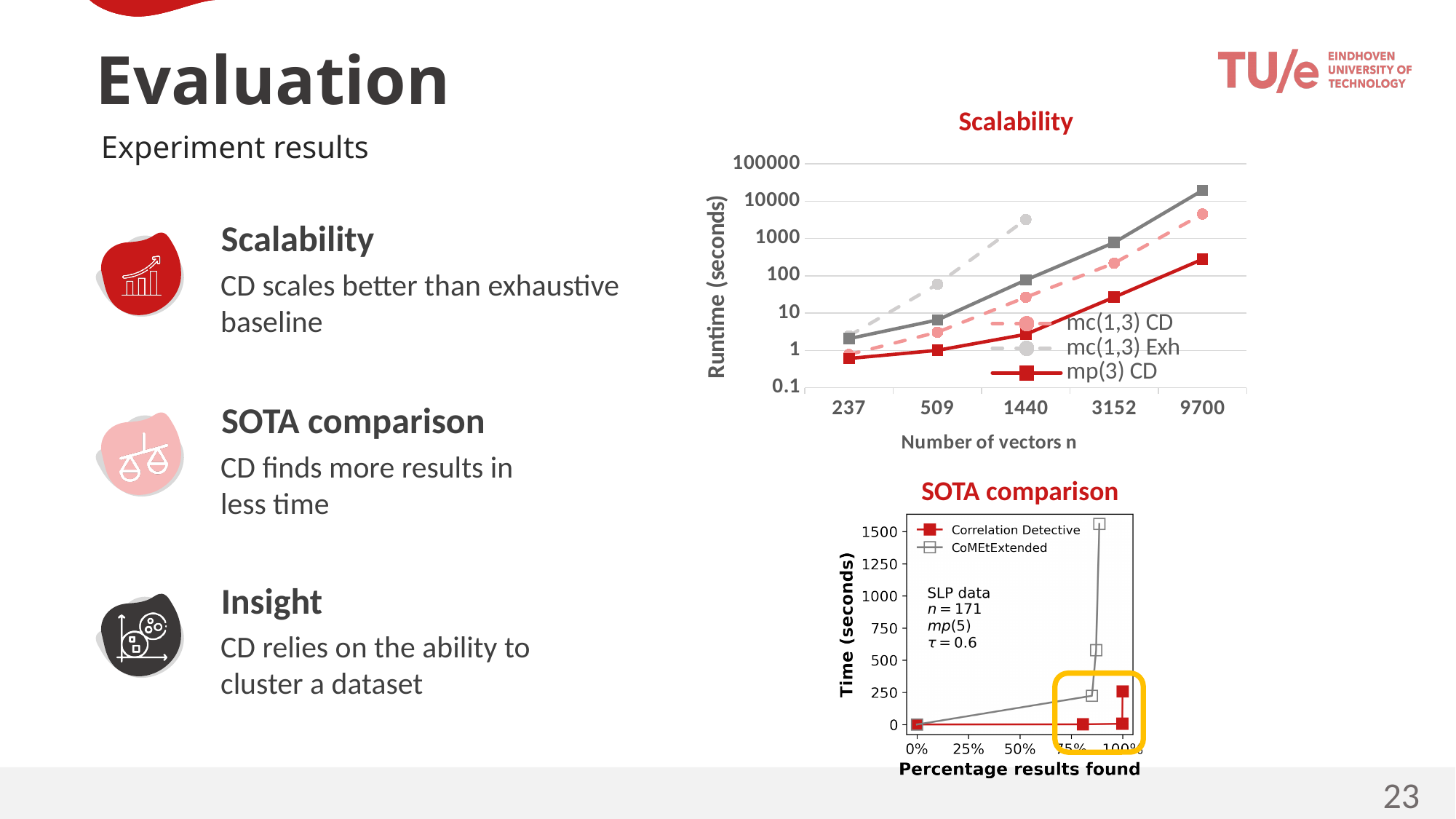
On the SOTA comparison chart, is the highest time for CoMEtExtended greater or less than 1250? greater On the Scalability chart, is the runtime for mc(1,3) Exh at n = 1440 greater or less than 1000? greater On the Scalability chart, how many values of n are shown on the x axis? 5 On the SOTA comparison chart, which series reaches the highest time? CoMEtExtended On the Scalability chart, is the runtime for mp(3) CD at n = 9700 greater or less than 100? greater On the SOTA comparison chart, what is the label of the x axis? Percentage results found On the SOTA comparison chart, how many series does the legend list? 2 On the Scalability chart, what is the label of the y axis? Runtime (seconds) On the Scalability chart, which series has the lowest runtime at n = 3152? mp(3) CD On the Scalability chart, does runtime rise or fall as the number of vectors n increases? rise On the Scalability chart, what kind of chart is it? line chart